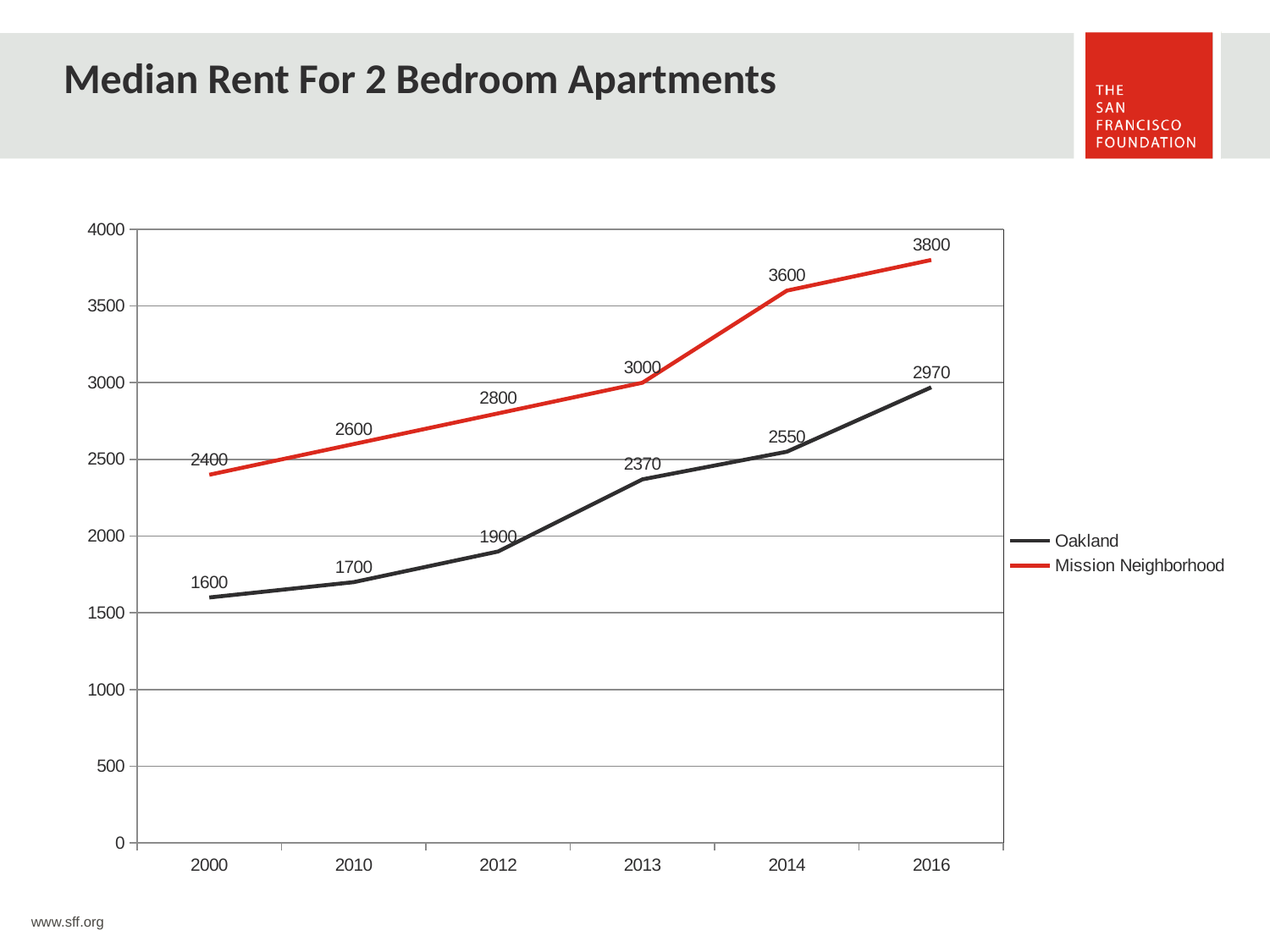
In which year is the Mission Neighborhood median rent highest? 2016 How many years are plotted on the x axis? 6 What is the median rent for Oakland in 2000? 1600 What colour is the line for the Mission Neighborhood? Red What is the median rent for the Mission Neighborhood in 2014? 3600 What is the median rent for Oakland in 2013? 2370 Do the Oakland median rent values rise or fall from 2000 to 2016? Rise In which year is the Oakland median rent lowest? 2000 Which is larger in 2012: the Oakland median rent or the Mission Neighborhood median rent? Mission Neighborhood How many series does the legend list? 2 What is the difference between the Mission Neighborhood and Oakland median rents in 2016? 830 What kind of chart is shown on the slide? Line chart